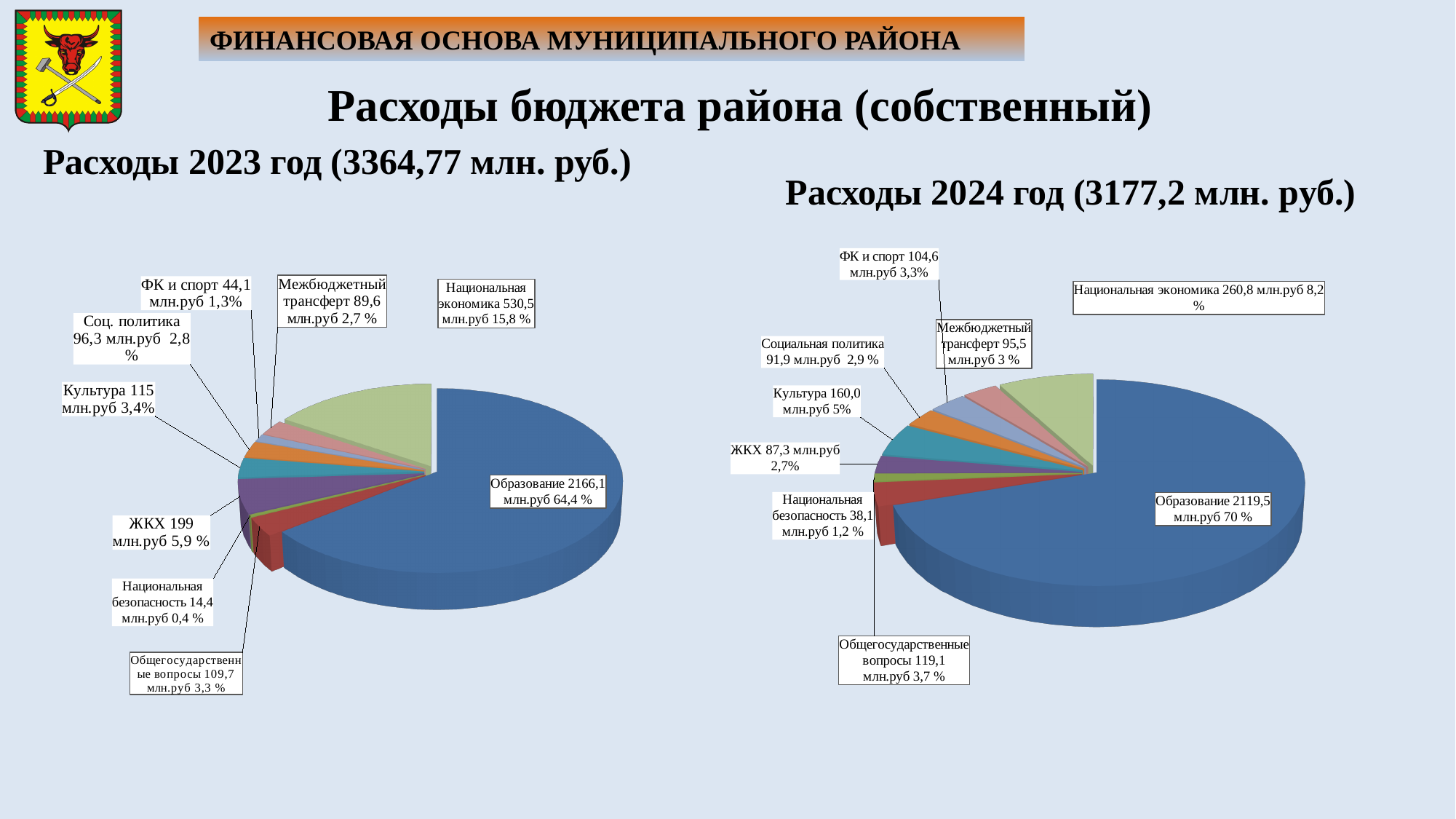
What type of chart is used for 'Расходы 2023 год'? Pie chart In the 'Расходы 2023 год' chart, what is the difference between ЖКХ and Культура? 84 млн.руб In the 'Расходы 2023 год' chart, which category has the smallest value? Национальная безопасность In the 'Расходы 2024 год' chart, what is the value for Культура? 160,0 млн.руб In the 'Расходы 2023 год' chart, what share of the pie does Национальная экономика have? 15,8 % In the 'Расходы 2024 год' chart, what share of the pie does Образование have? 70 % In the 'Расходы 2024 год' chart, what is the difference between Общегосударственные вопросы and Межбюджетный трансферт? 23,6 млн.руб How many slices are in the 'Расходы 2023 год' pie chart? 9 What total is shown in the title of the 'Расходы 2024 год' chart? 3177,2 млн. руб. In the 'Расходы 2023 год' chart, what is the value for Образование? 2166,1 млн.руб In the 'Расходы 2024 год' chart, which category has the largest value? Образование In the 'Расходы 2024 год' chart, which is larger: ФК и спорт or ЖКХ? ФК и спорт